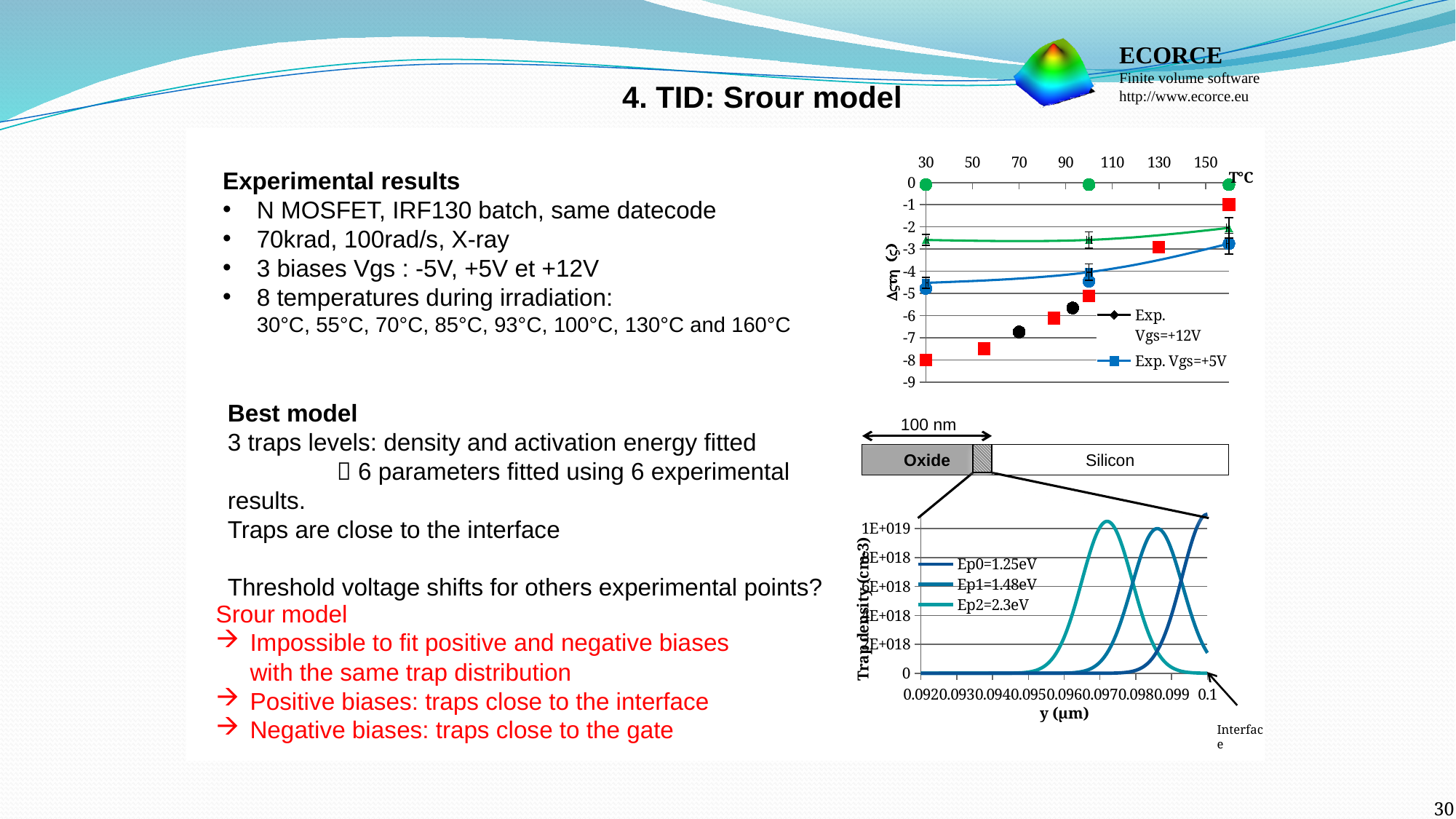
How many series does the legend of the bottom-right trap density chart list? 3 In the bottom-right trap density chart, what is the highest value shown on the y axis? 1E+019 In the top-right ΔVth versus T°C chart, does the Exp. Vgs=+5V series rise or fall as temperature increases from 30 to 160°C? rise In the bottom-right trap density chart, what are the three legend entries? Ep0=1.25eV, Ep1=1.48eV, Ep2=2.3eV In the bottom-right trap density chart, which series reaches its maximum at the interface (y = 0.1 µm)? Ep0=1.25eV In the top-right ΔVth versus T°C chart, is the value of the Exp. Vgs=+5V series at 30°C greater or less than -4? less In the top-right ΔVth versus T°C chart, what is the lowest value shown on the y axis? -9 How many series does the legend of the top-right ΔVth versus T°C chart list? 2 What kind of chart is the bottom-right chart of trap density versus y (µm)? line chart In the bottom-right trap density chart, which series has its peak at the smallest y value (furthest from the interface)? Ep2=2.3eV